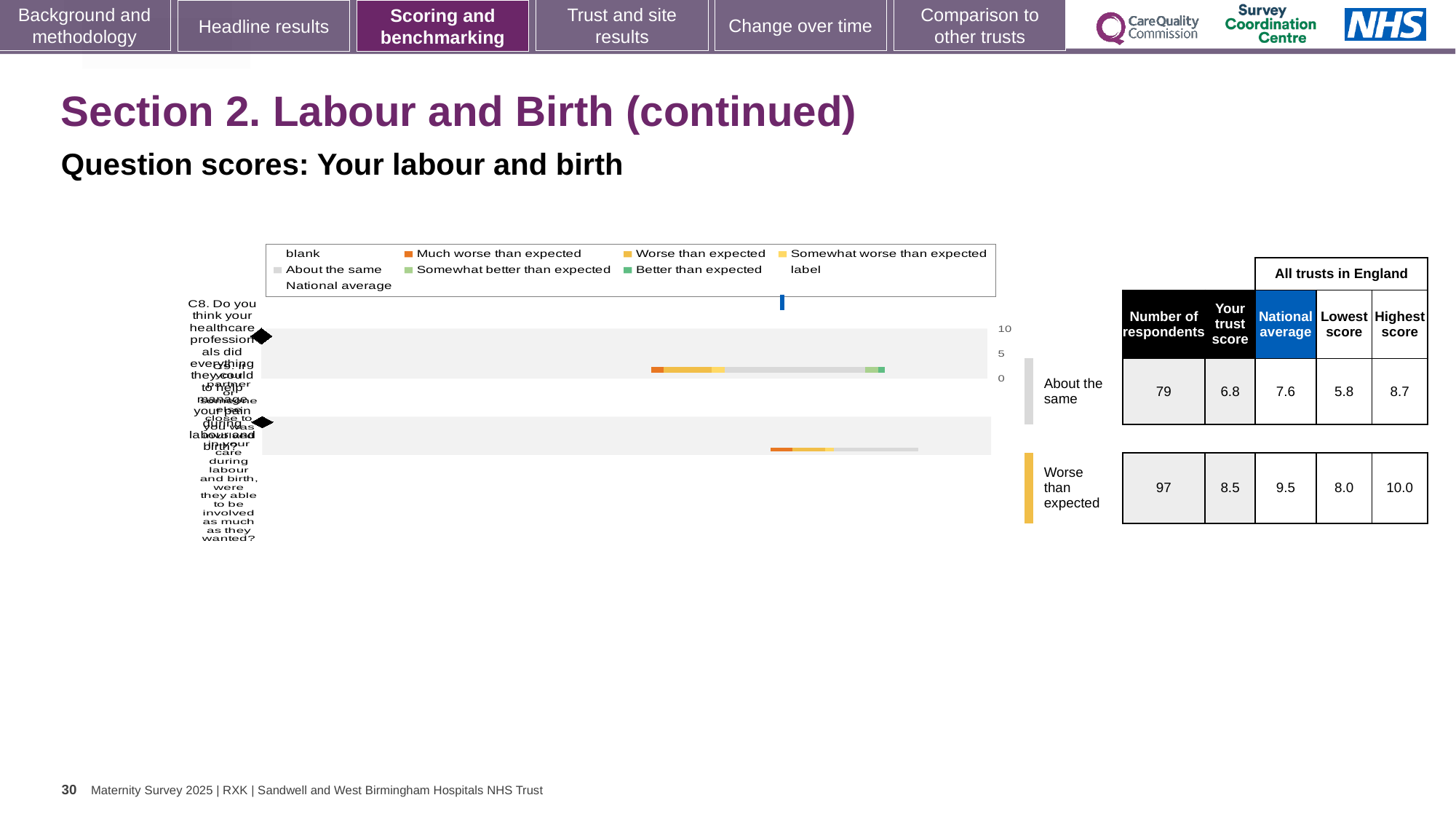
Which legend entry is shown in orange? Much worse than expected In the table, what is the trust score for the row rated 'Worse than expected'? 8.5 In the table, what is the national average for the row rated 'About the same'? 7.6 How many bars (question rows) are plotted in the chart? 2 In the table, what is the difference between the national average and the trust score for the row rated 'About the same'? 0.8 In the table, which row has more respondents: 'About the same' or 'Worse than expected'? Worse than expected How many entries does the chart legend list? 9 What is the heading above the Lowest score and Highest score columns in the table? All trusts in England In the table, what is the highest score for the row rated 'Worse than expected'? 10.0 In the table, which is larger for the row rated 'Worse than expected': the trust score or the national average? national average In the table, what is the number of respondents for the row rated 'About the same'? 79 What kind of chart is shown on the slide? bar chart